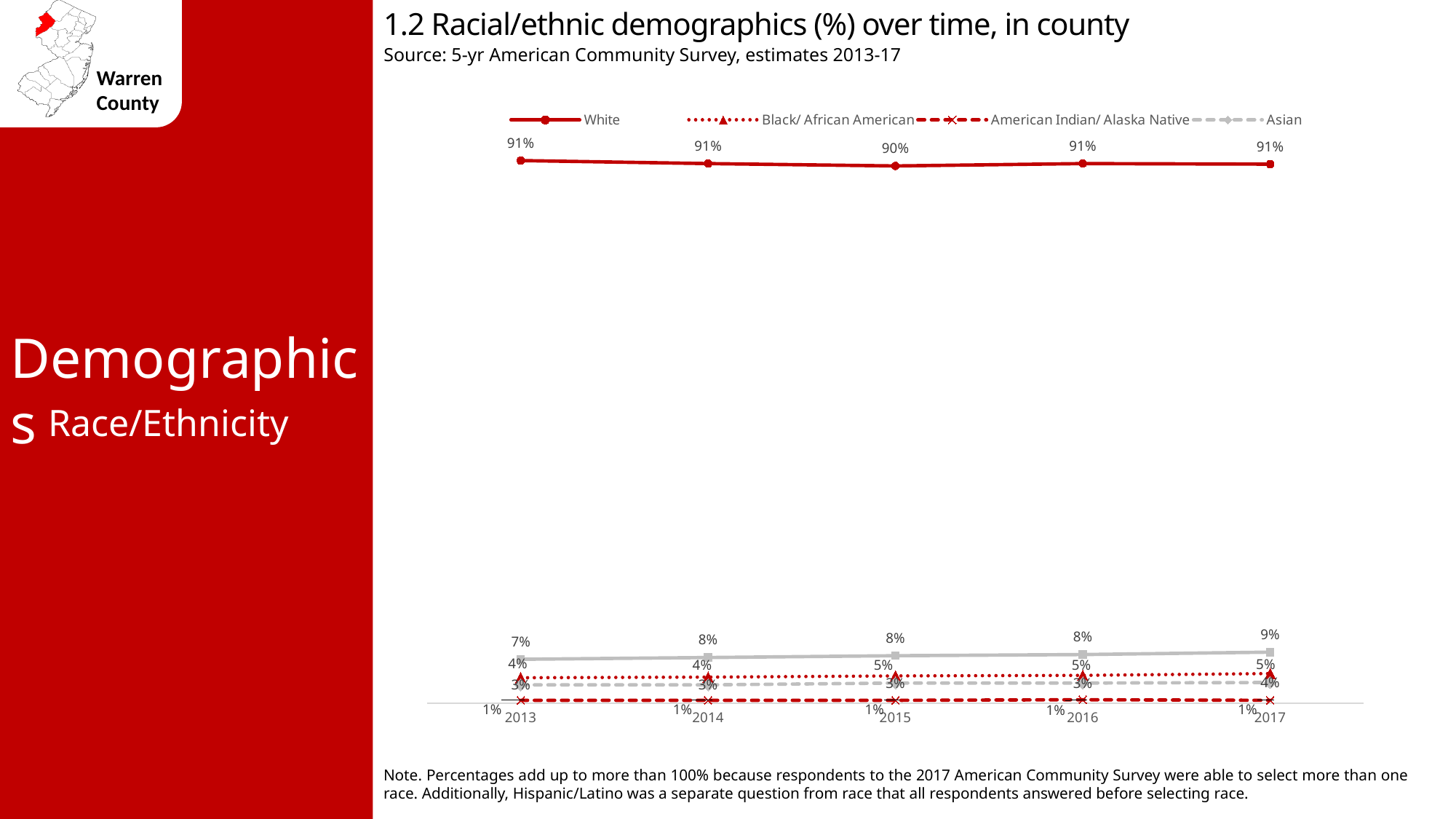
What is the value for American Indian/ Alaska Native in 2014? 1% What is the title of the chart? 1.2 Racial/ethnic demographics (%) over time, in county In 2015, which is larger: the Black/ African American value or the Asian value? Black/ African American What is the difference between the White value and the Black/ African American value in 2013? 87 percentage points Does the Black/ African American series rise or fall from 2013 to 2017? Rises How many series does the legend list? 4 How many years are shown on the x axis? 5 What kind of chart is shown on the slide? Line chart What is the value for Black/ African American in 2017? 5% In which year is the White series at its lowest value? 2015 What is the value for Asian in 2017? 4% What is the value for White in 2015? 90%